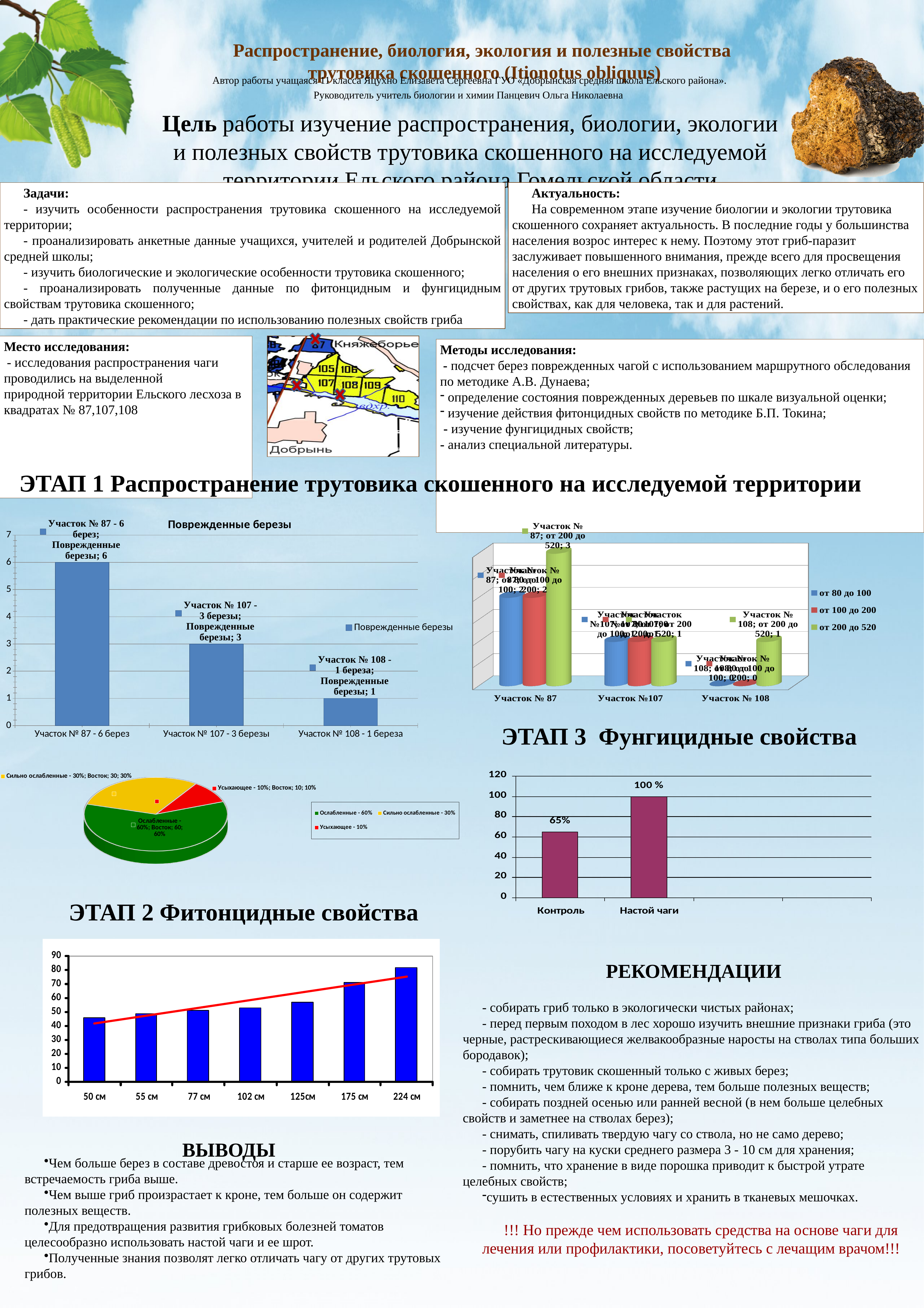
In the 3D bar chart at the top right, what is the value of the 'от 80 до 100' series for Участок № 108? 0 In the 'Поврежденные березы' bar chart, which category has the lowest value? Участок № 108 - 1 береза In the pie chart, which slice is the smallest? Усыхающее - 10% In the 'ЭТАП 3 Фунгицидные свойства' bar chart, which is larger, Контроль or Настой чаги? Настой чаги In the 'Поврежденные березы' bar chart, what is the difference between the values for Участок № 87 and Участок № 107? 3 In the 3D bar chart at the top right, how many series does the legend list? 3 In the pie chart, what share does 'Ослабленные' have? 60% In the 'Поврежденные березы' bar chart, what is the value for Участок № 87? 6 In the 'Поврежденные березы' bar chart, how many categories are shown on the x axis? 3 In the 'ЭТАП 3 Фунгицидные свойства' bar chart, what is the value for Контроль? 65% In the 'ЭТАП 2 Фитонцидные свойства' bar chart, do the values rise or fall from 50 см to 224 см? rise In the 3D bar chart at the top right, what is the value of the 'от 200 до 520' series for Участок № 87? 3